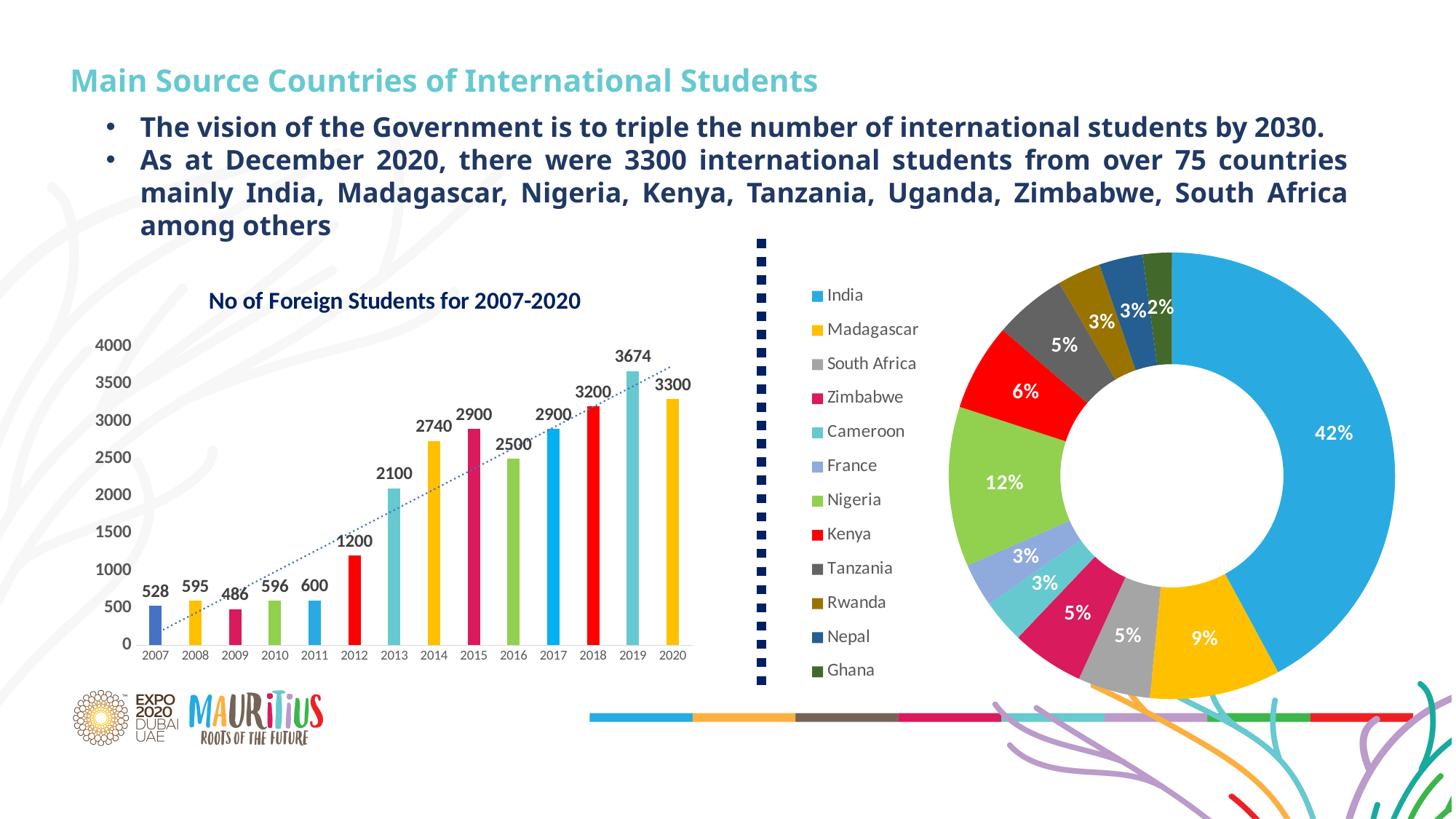
In the 'No of Foreign Students for 2007-2020' chart, what is the value for 2013? 2100 How many countries are listed in the legend of the pie chart on the right? 12 In the 'No of Foreign Students for 2007-2020' chart, do the values generally rise or fall from 2007 to 2020? Rise In the 'No of Foreign Students for 2007-2020' chart, which year has the highest value? 2019 In the 'No of Foreign Students for 2007-2020' chart, which is larger, the value for 2016 or the value for 2017? 2017 In the 'No of Foreign Students for 2007-2020' chart, what is the value for 2019? 3674 In the pie chart on the right, what share does India have? 42% In the 'No of Foreign Students for 2007-2020' chart, what is the difference between the values for 2019 and 2020? 374 How many years are shown in the 'No of Foreign Students for 2007-2020' chart? 14 In the 'No of Foreign Students for 2007-2020' chart, which year has the lowest value? 2009 In the pie chart on the right, what share does Nigeria have? 12% What kind of chart is the 'No of Foreign Students for 2007-2020' chart? Bar chart